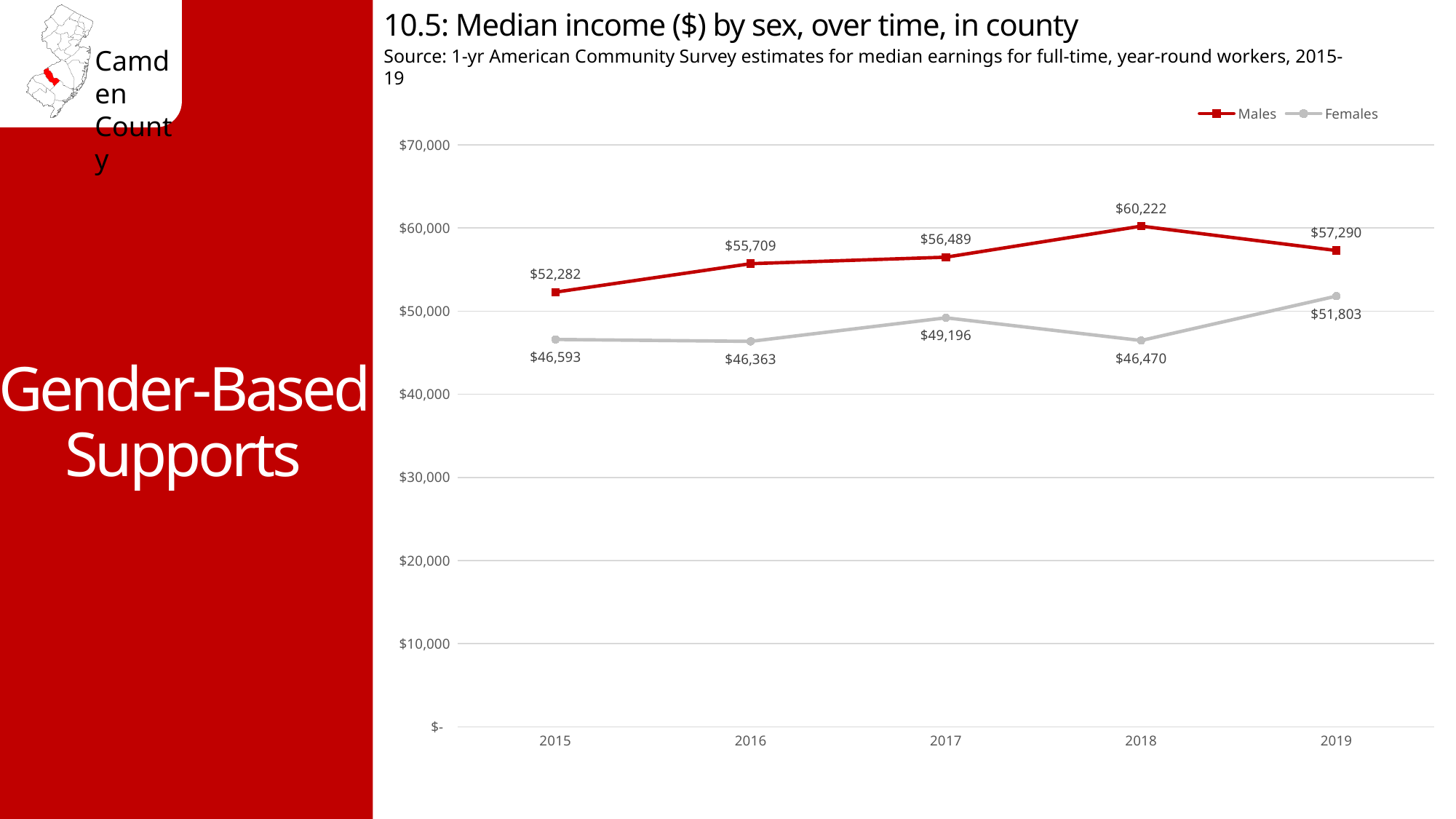
What kind of chart is shown on the slide? line chart How many series does the legend list? 2 What was the median income for Males in 2018? $60,222 In which year was the median income for Females lowest? 2016 What was the median income for Females in 2017? $49,196 How many years are shown on the x axis? 5 Which was larger in 2015, the median income for Males or for Females? Males What was the median income for Females in 2019? $51,803 What is the difference between the Males median income in 2018 and 2019? $2,932 In which year was the median income for Males highest? 2018 What is the difference between the Males and Females median income in 2019? $5,487 Is the median income for Females in 2018 greater or less than $50,000? less